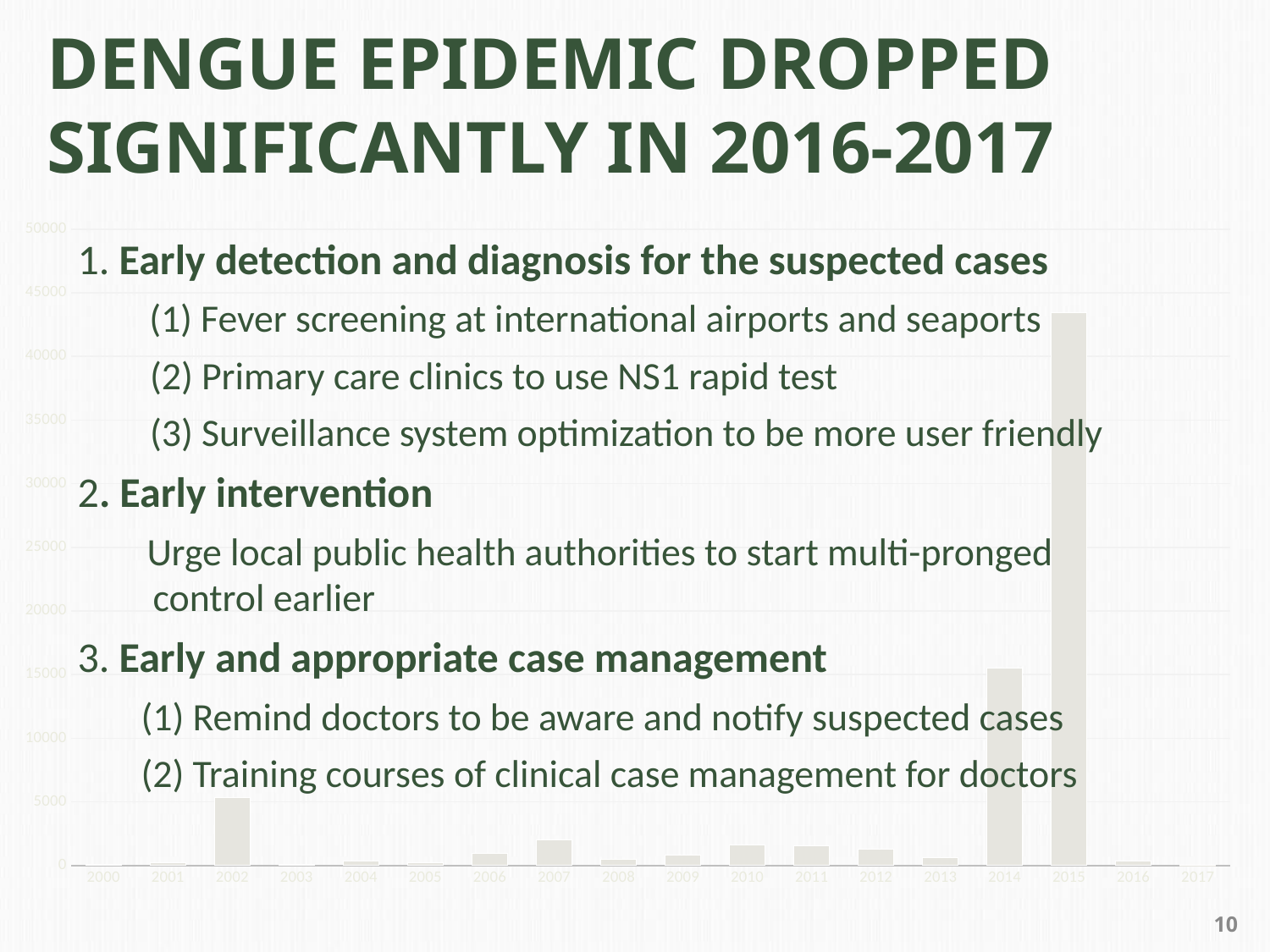
Is the value for 2007 greater or less than 5000? less Is the value for 2002 greater or less than 10000? less Which is larger, the value for 2014 or the value for 2015? 2015 What is the highest value labelled on the y axis of the chart? 50000 Is the value for 2014 greater or less than 10000? greater Which is larger, the value for 2002 or the value for 2014? 2014 How many years are shown on the x axis of the chart? 18 Which year has the highest bar in the chart? 2015 What kind of chart is shown on the slide? bar chart What is the first year shown on the x axis of the chart? 2000